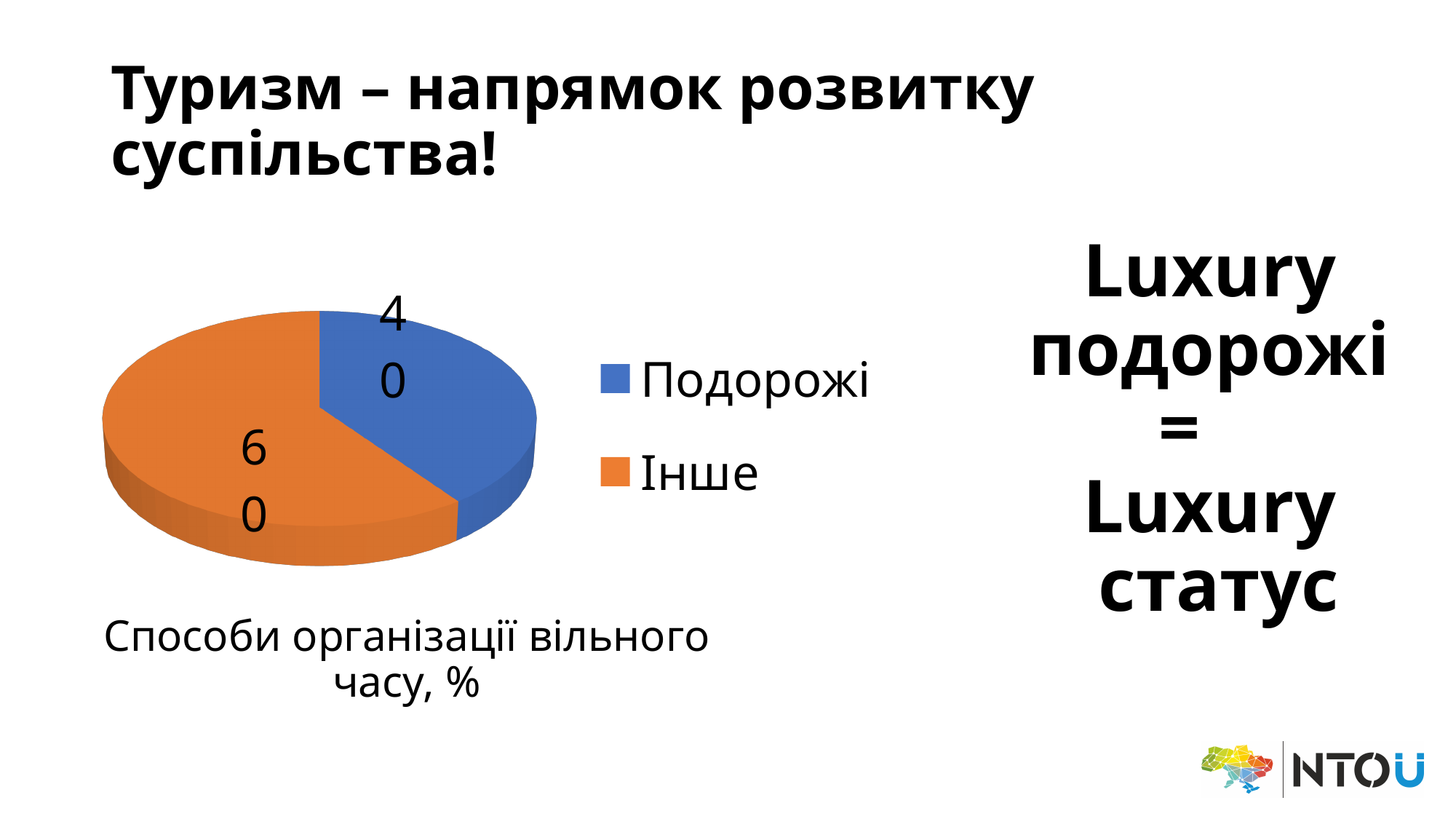
What is the value for Інше in the pie chart? 60 Which category has the largest slice in the pie chart? Інше How many entries does the legend list? 2 What is the value for Подорожі in the pie chart? 40 What is the title of the pie chart? Способи організації вільного часу, % What type of chart is shown on the slide? pie chart What is the difference between the values for Інше and Подорожі? 20 What share of the pie does Подорожі represent? 40% Which is larger, the value for Подорожі or the value for Інше? Інше Which category has the smallest slice in the pie chart? Подорожі How many slices does the pie chart have? 2 What colour is the Інше slice in the pie chart? orange